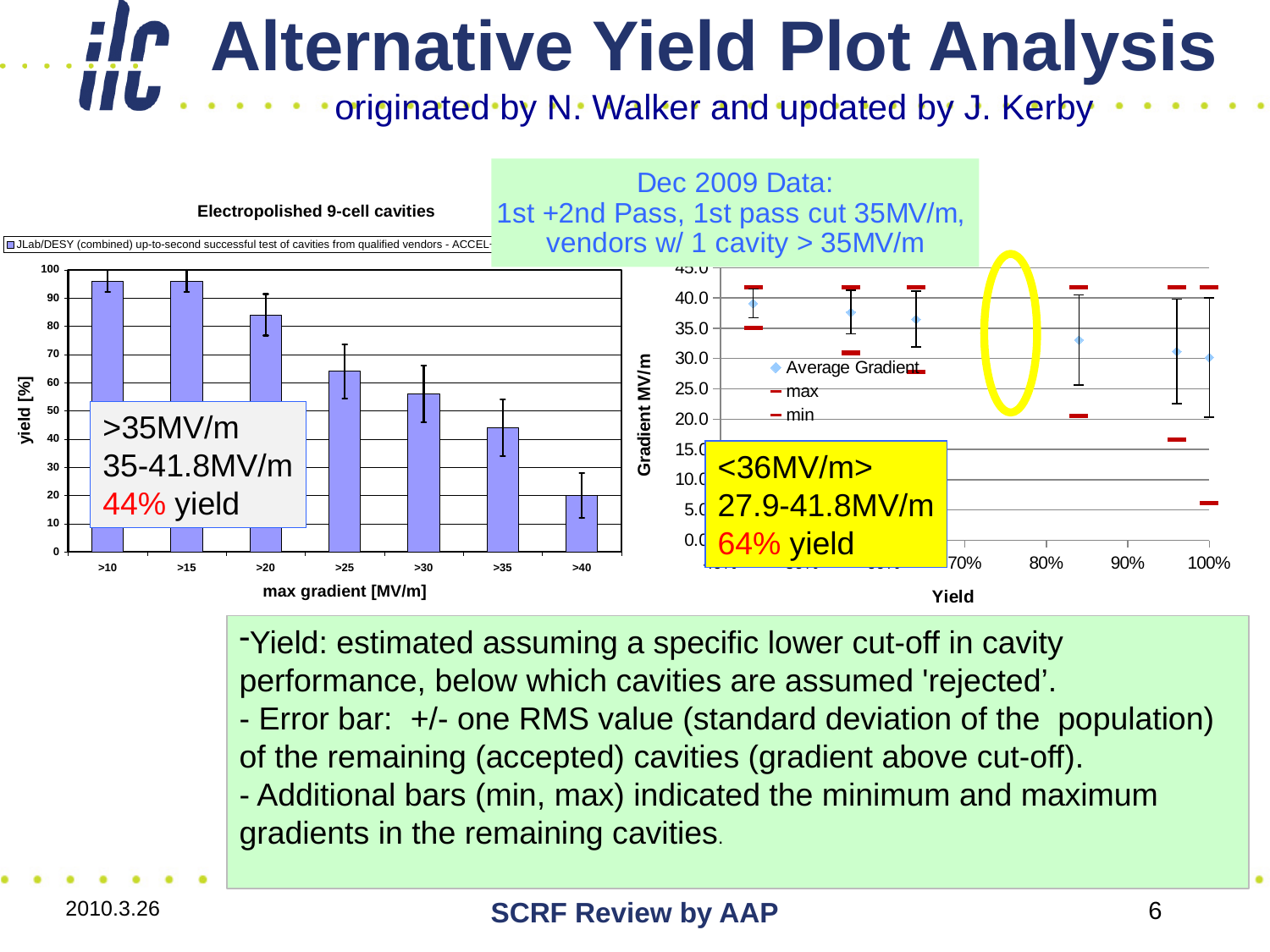
What are the legend entries of the right chart (Gradient MV/m vs Yield)? Average Gradient, max, min In the left chart 'Electropolished 9-cell cavities', how many max gradient categories are shown on the x axis? 7 In the left chart 'Electropolished 9-cell cavities', does the yield rise or fall as the max gradient cut-off increases from >10 to >40? fall According to the callout on the left chart, what is the yield for the >35MV/m cut-off? 44% What kind of chart is the left chart titled 'Electropolished 9-cell cavities'? bar chart What is the y-axis label of the left chart 'Electropolished 9-cell cavities'? yield [%] In the left chart 'Electropolished 9-cell cavities', is the yield for >40 greater or less than 30? less How many series does the legend of the right chart (Gradient MV/m vs Yield) list? 3 In the left chart 'Electropolished 9-cell cavities', which max gradient category has the lowest yield? >40 In the left chart 'Electropolished 9-cell cavities', is the yield for >20 greater or less than 80? greater In the left chart 'Electropolished 9-cell cavities', which has the higher yield, >20 or >30? >20 In the left chart 'Electropolished 9-cell cavities', is the yield for >25 greater or less than 70? less